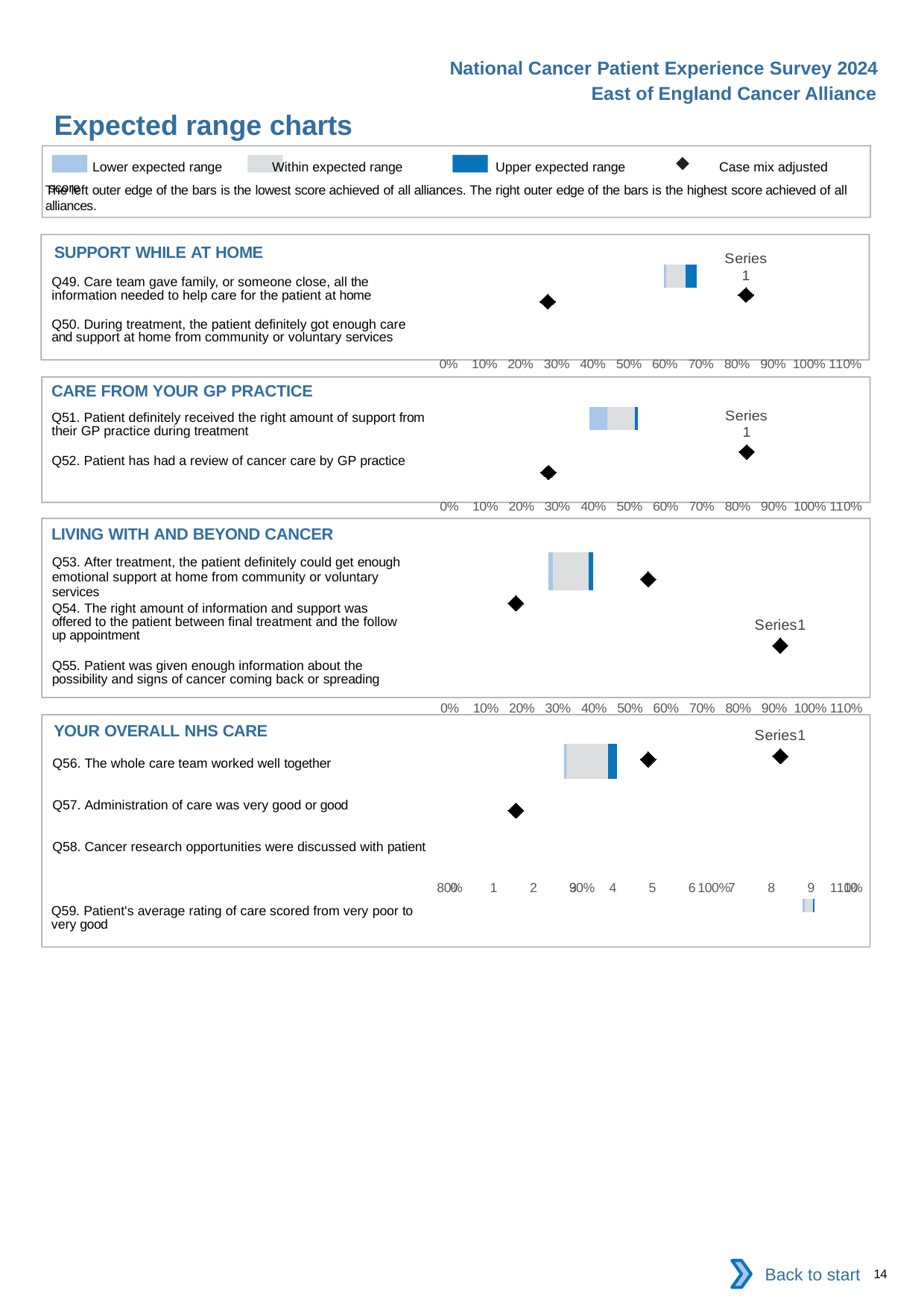
In the SUPPORT WHILE AT HOME chart, is the rightmost diamond marker greater or less than 70%? greater How many questions are listed in the YOUR OVERALL NHS CARE chart? 4 What is the highest value shown on the x axis of the LIVING WITH AND BEYOND CANCER chart? 110% What kind of chart is used in the SUPPORT WHILE AT HOME section? bar chart What is the title of the slide? Expected range charts In the SUPPORT WHILE AT HOME chart, is the leftmost diamond marker greater or less than 50%? less How many questions are listed in the LIVING WITH AND BEYOND CANCER chart? 3 How many questions are listed in the SUPPORT WHILE AT HOME chart? 2 In the LIVING WITH AND BEYOND CANCER chart, is the rightmost diamond marker greater or less than 80%? greater How many entries does the legend at the top of the slide list? 4